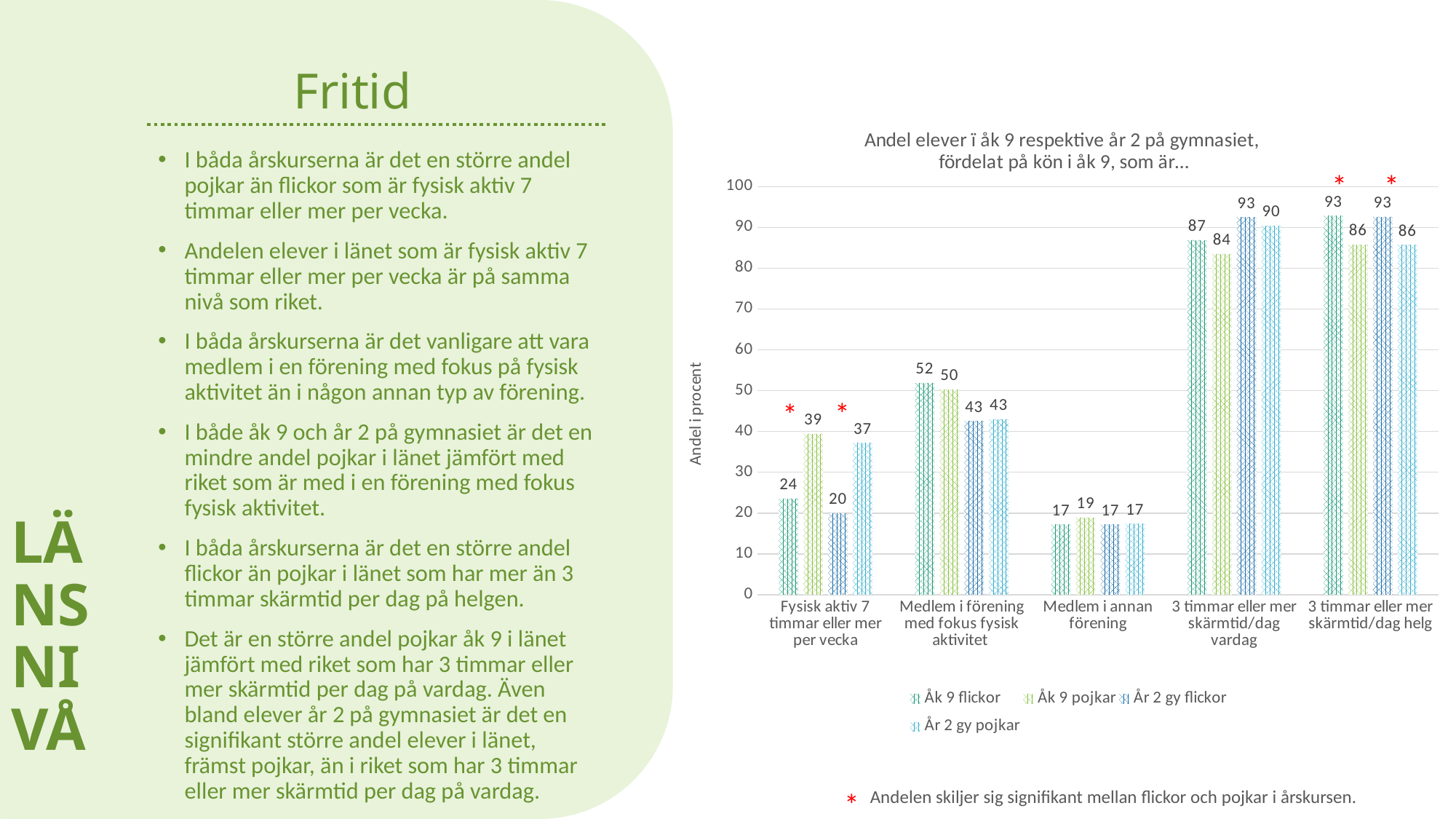
How many categories are shown on the x axis? 5 Which series has the lowest value in the category 'Fysisk aktiv 7 timmar eller mer per vecka'? År 2 gy flickor What is the value for Åk 9 pojkar in the category 'Fysisk aktiv 7 timmar eller mer per vecka'? 39 How many series does the legend list? 4 What is the value for Åk 9 flickor in the category 'Medlem i förening med fokus fysisk aktivitet'? 52 What kind of chart is shown on the slide? Bar chart Which series has the highest value in the category 'Medlem i annan förening'? Åk 9 pojkar What is the difference between Åk 9 pojkar and Åk 9 flickor in the category 'Fysisk aktiv 7 timmar eller mer per vecka'? 15 What is the value for År 2 gy flickor in the category '3 timmar eller mer skärmtid/dag vardag'? 93 What is the label of the vertical axis? Andel i procent Which is larger in the category '3 timmar eller mer skärmtid/dag helg': Åk 9 flickor or Åk 9 pojkar? Åk 9 flickor What is the difference between År 2 gy pojkar in '3 timmar eller mer skärmtid/dag vardag' and in '3 timmar eller mer skärmtid/dag helg'? 4